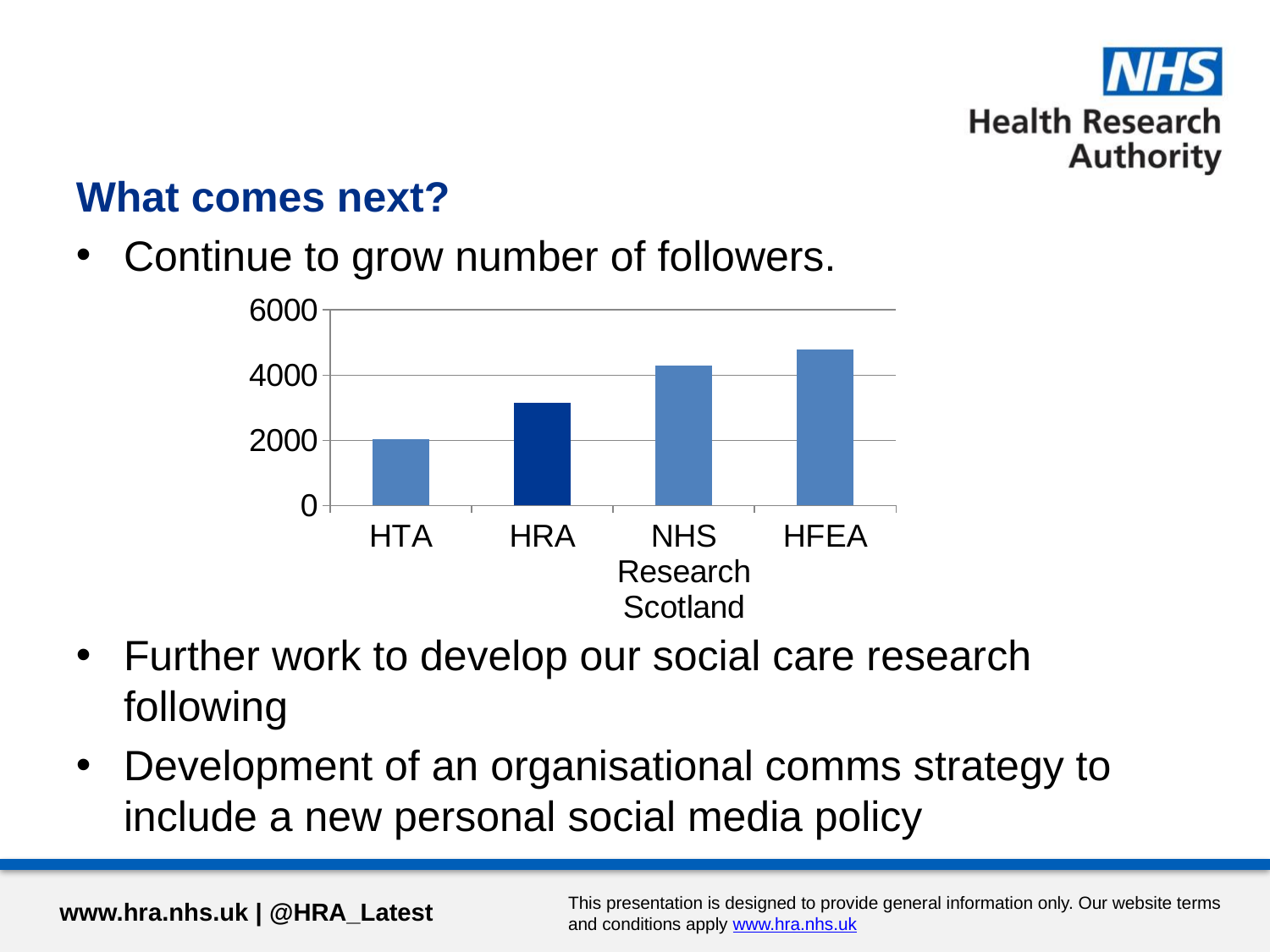
Which category's bar is shown in a darker blue than the others? HRA Which has the larger value, HRA or NHS Research Scotland? NHS Research Scotland What kind of chart is shown on the slide? bar chart How many categories are shown on the x axis of the chart? 4 Which category has the highest bar in the chart? HFEA Is the value for NHS Research Scotland greater or less than 4000? greater Which has the larger value, HTA or HRA? HRA Is the value for HFEA greater or less than 4000? greater Do the bar values rise or fall from left to right across the x axis? rise Is the value for HRA greater or less than 4000? less Which category has the lowest bar in the chart? HTA